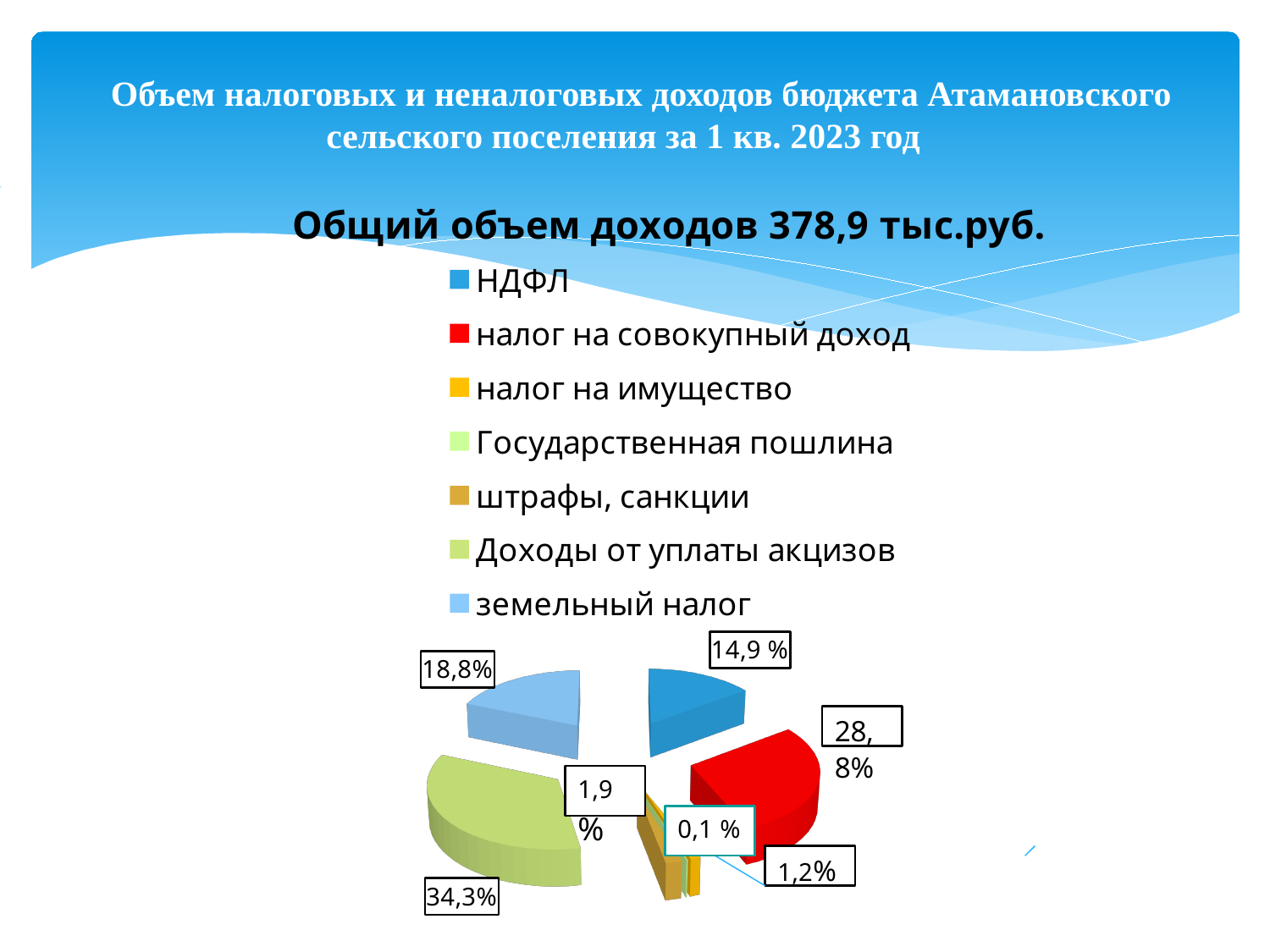
What share of the pie does земельный налог account for? 18,8% What kind of chart is shown on the slide? pie chart How many categories does the legend of the pie chart list? 7 Which is larger: the share for НДФЛ or the share for земельный налог? земельный налог Which legend entry is shown in red? налог на совокупный доход What is the smallest percentage labelled on the pie chart? 0,1 % What share of the pie does Доходы от уплаты акцизов account for? 34,3% What share of the pie does НДФЛ account for? 14,9 % By how many percentage points does the share of Доходы от уплаты акцизов exceed the share of налог на совокупный доход? 5,5 Which category has the largest slice of the pie? Доходы от уплаты акцизов What total income amount is stated above the pie chart? 378,9 тыс.руб.